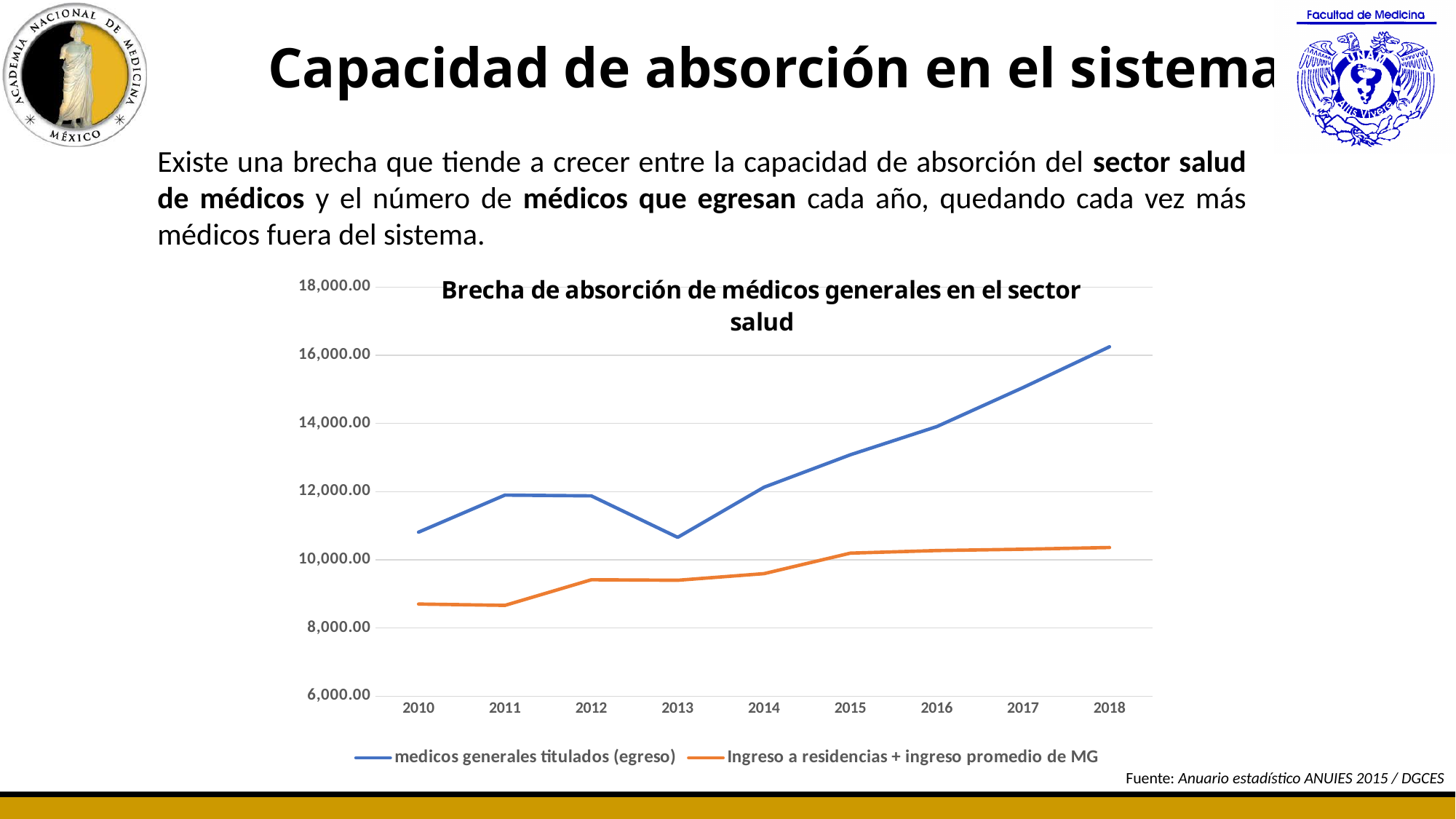
What is the title of the chart? Brecha de absorción de médicos generales en el sector salud What kind of chart is shown on the slide? line chart Which series is drawn in orange? Ingreso a residencias + ingreso promedio de MG Is the value for 'Ingreso a residencias + ingreso promedio de MG' in 2012 greater or less than 10,000.00? less How many years are plotted along the x axis? 9 In 2018, which series has the larger value: 'medicos generales titulados (egreso)' or 'Ingreso a residencias + ingreso promedio de MG'? medicos generales titulados (egreso) How many series does the legend list? 2 Is the value for 'medicos generales titulados (egreso)' in 2018 greater or less than 16,000.00? greater In which year is the value for 'medicos generales titulados (egreso)' highest? 2018 Does the 'medicos generales titulados (egreso)' series rise or fall from 2013 to 2018? rise Is the value for 'medicos generales titulados (egreso)' in 2017 greater or less than 14,000.00? greater